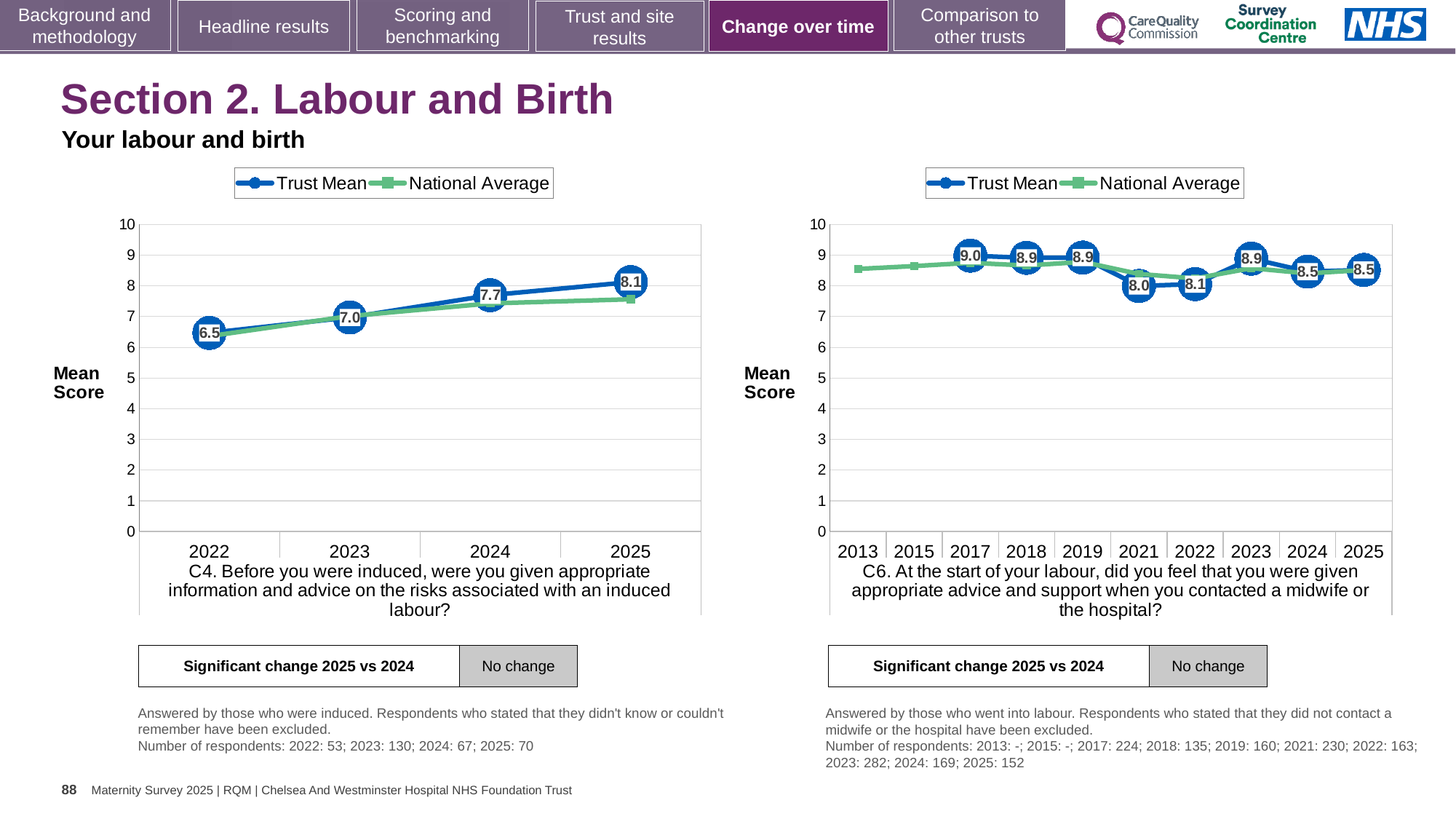
In the left chart (C4), does the Trust Mean rise or fall from 2022 to 2025? rise What kind of chart is the left chart (C4)? line chart In the left chart (C4), which year has the lowest Trust Mean score? 2022 In the left chart (C4), what is the difference between the Trust Mean scores for 2025 and 2022? 1.6 In the right chart (C6), is the Trust Mean score for 2023 larger or smaller than the score for 2024? larger In the right chart (C6), what is the Trust Mean score for 2021? 8.0 In the left chart (C4), what is the Trust Mean score for 2022? 6.5 In the right chart (C6), what is the Trust Mean score for 2017? 9.0 In the left chart (C4), what is the Trust Mean score for 2025? 8.1 In the right chart (C6), which year has the highest Trust Mean score? 2017 In the right chart (C6), how many series does the legend list? 2 In the left chart (C4), how many years are shown on the x axis? 4